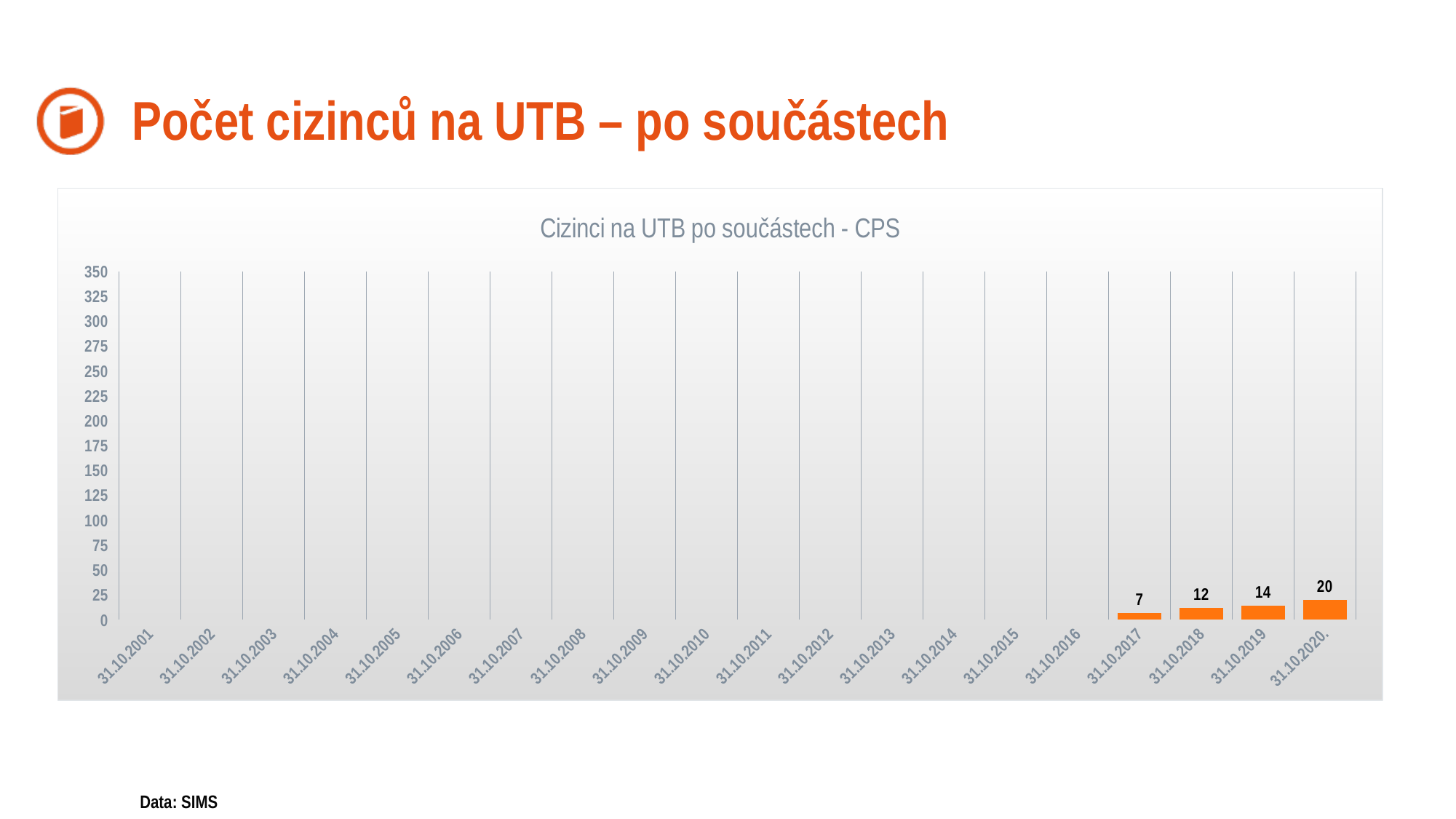
What is the value for 31.10.2017 in the chart? 7 What is the difference between the values for 31.10.2019 and 31.10.2018? 2 Is the value for 31.10.2020 greater or less than 25? less What kind of chart is shown on the slide? bar chart What is the value for 31.10.2020 in the chart? 20 Do the values rise or fall from 31.10.2017 to 31.10.2020? rise What is the difference between the values for 31.10.2020 and 31.10.2017? 13 Which is larger, the value for 31.10.2018 or the value for 31.10.2019? 31.10.2019 Which date has the highest value in the chart? 31.10.2020 What is the value for 31.10.2018 in the chart? 12 What is the value for 31.10.2019 in the chart? 14 How many dates are shown on the x axis of the chart? 20